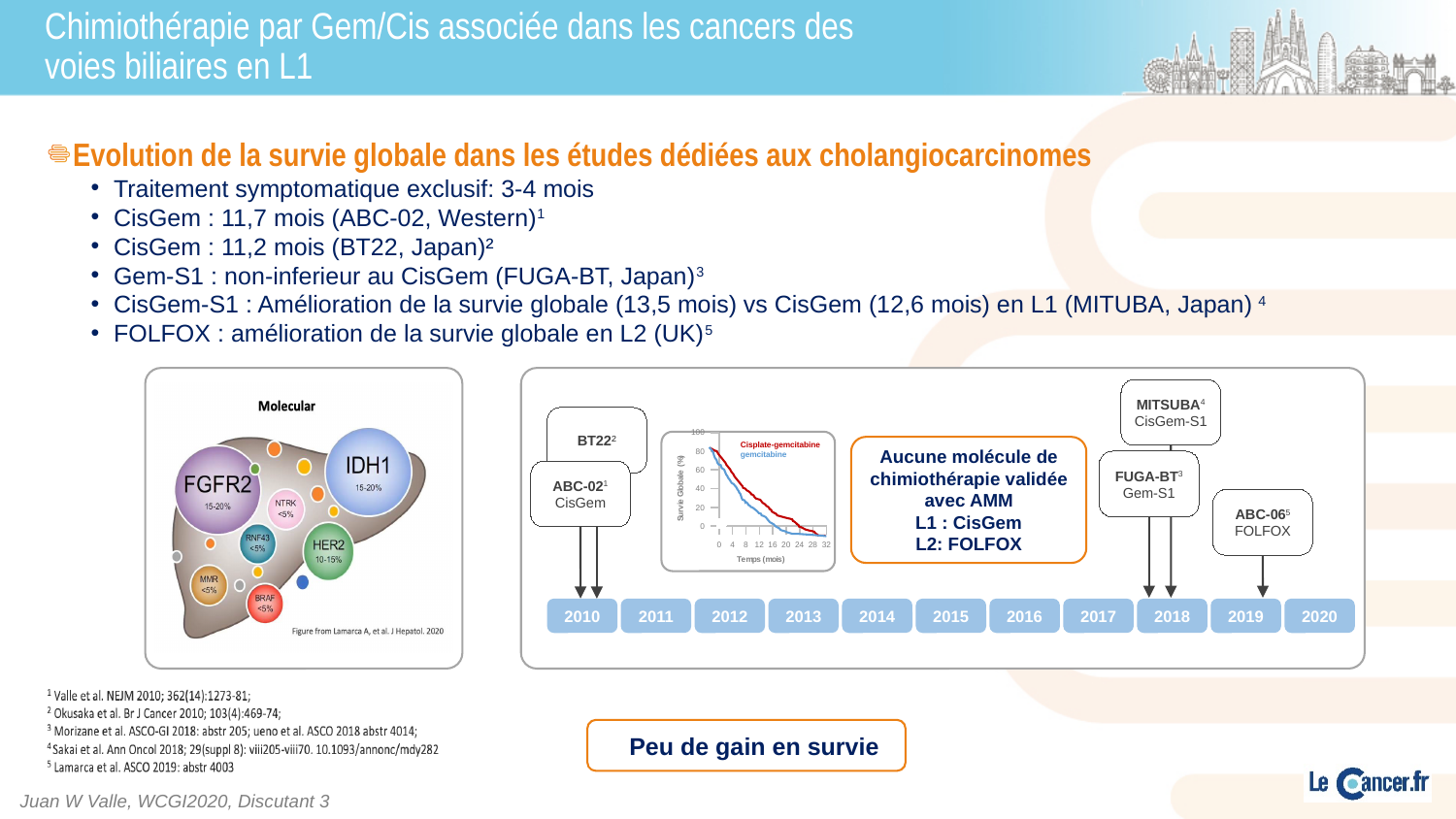
In the survival curve chart, which curve lies higher over most of the follow-up, Cisplate-gemcitabine or gemcitabine? Cisplate-gemcitabine In the Molecular liver figure on the left, what percentage is shown for FGFR2? 15-20% In the survival curve chart, do the curves rise or fall as time (Temps, mois) increases? fall In the survival curve chart, which series is shown in blue? gemcitabine How many series does the legend of the survival curve chart list? 2 In the survival curve chart, which series is shown in red? Cisplate-gemcitabine In the Molecular liver figure on the left, what percentage is shown for IDH1? 15-20% In the Molecular liver figure on the left, what percentage is shown for HER2? 10-15% In the Molecular liver figure on the left, how many molecular alterations are labelled? 7 What is the highest tick value shown on the x axis (Temps, mois) of the survival curve chart? 32 What kind of chart is the small survival plot in the middle of the slide? line chart What is the highest tick value shown on the y axis (Survie Globale %) of the survival curve chart? 100